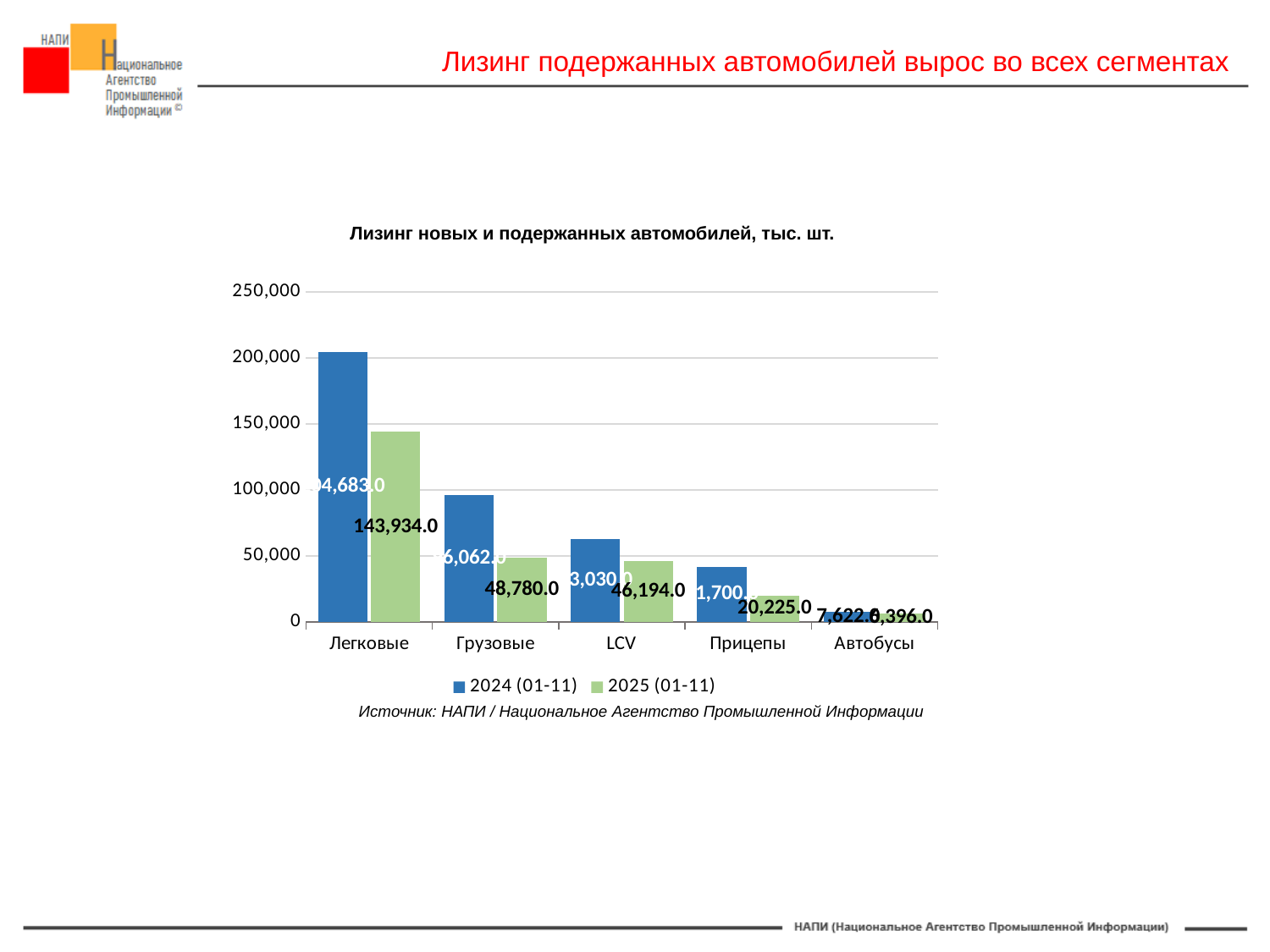
Which category has the highest value in the 2024 (01-11) series? Легковые What is the value for Прицепы in the 2025 (01-11) series? 20,225.0 What is the value for LCV in the 2025 (01-11) series? 46,194.0 How many categories are shown on the x axis? 5 Which category has the lowest value in the 2025 (01-11) series? Автобусы What is the value for Легковые in the 2025 (01-11) series? 143,934.0 Is the value for Легковые in the 2024 (01-11) series greater or less than 200,000? greater What is the value for Грузовые in the 2025 (01-11) series? 48,780.0 How many series does the legend list? 2 What type of chart is shown on the slide? Bar chart What is the difference between the 2025 (01-11) values for Легковые and Грузовые? 95,154.0 What is the title of the chart? Лизинг новых и подержанных автомобилей, тыс. шт.